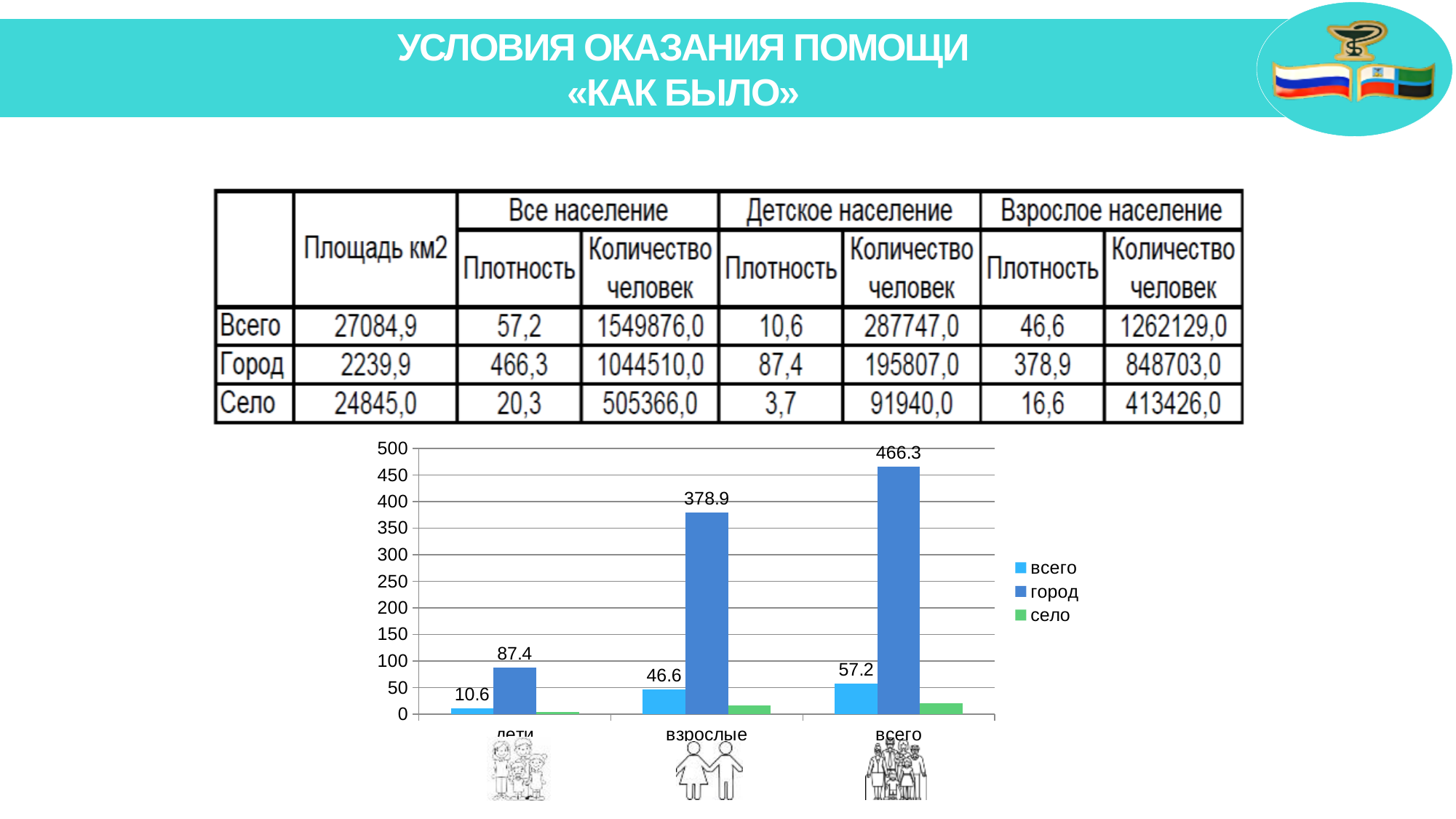
Which category has the highest value for the город series? всего What is the value of the всего series for the дети category? 10.6 Is the село value for the всего category greater or less than 50? less What is the value of the всего series for the взрослые category? 46.6 What kind of chart is shown on the slide? bar chart Which is larger for the взрослые category: the всего series or the город series? город What is the value of the город series for the дети category? 87.4 How many series does the chart legend list? 3 How many categories are shown on the x axis of the chart? 3 What is the value of the город series for the всего category? 466.3 What is the difference between the город values for всего and взрослые? 87.4 Which category has the lowest value for the всего series? дети